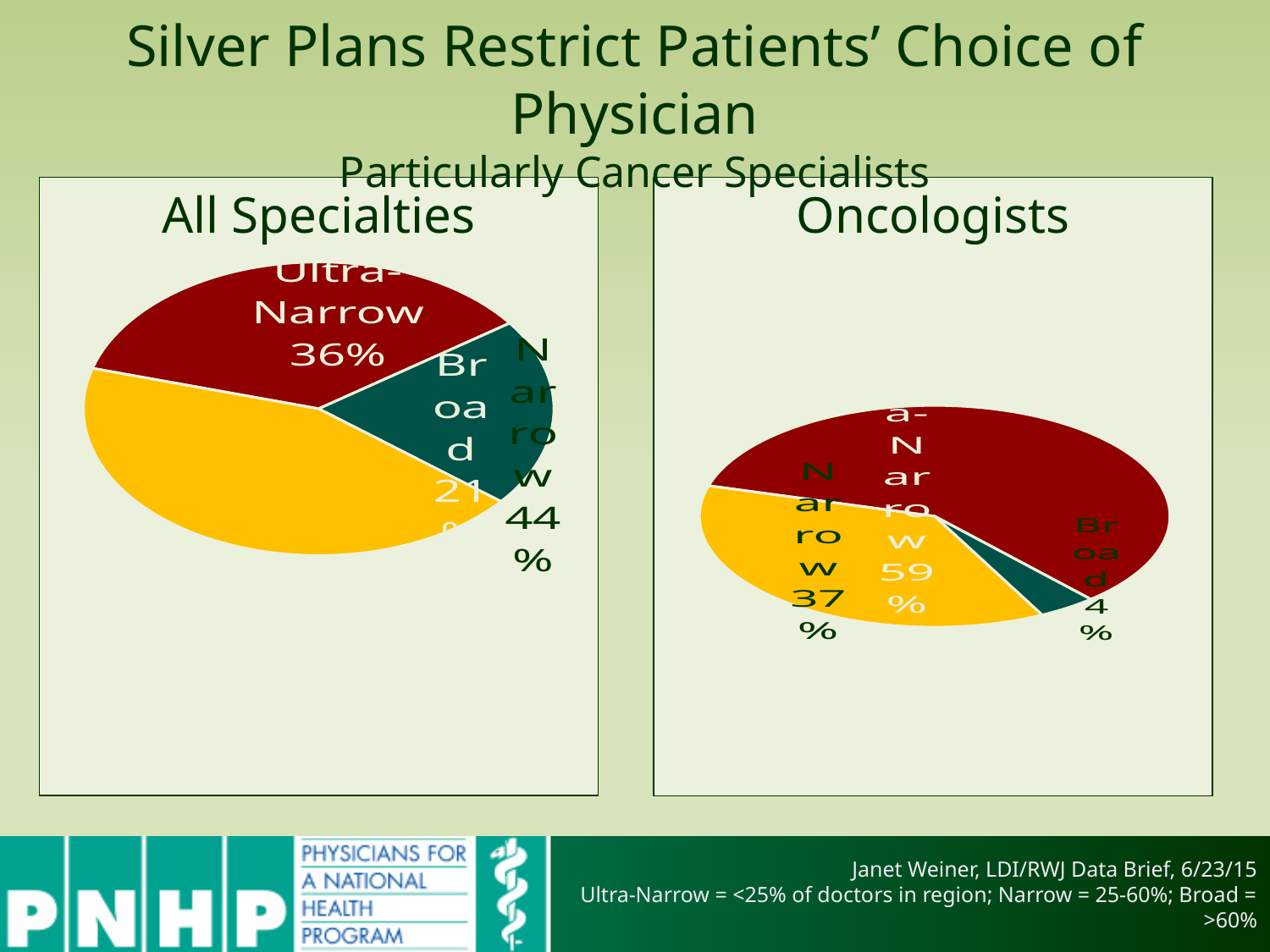
In the Oncologists chart, what percentage is labelled for Narrow? 37% In the All Specialties chart, what percentage is labelled for Ultra-Narrow? 36% What type of charts are shown on the slide? Pie charts In the All Specialties chart, which category has the largest slice? Narrow In the Oncologists chart, what is the difference between the Ultra-Narrow and Narrow percentages? 22% In the All Specialties chart, what percentage is labelled for Narrow? 44% In the Oncologists chart, what percentage is labelled for Broad? 4% How many slices does the Oncologists pie chart have? 3 In the All Specialties chart, which category has the smallest slice? Broad In the Oncologists chart, which category has the smallest slice? Broad In the Oncologists chart, what percentage is labelled for the Ultra-Narrow slice? 59% In the Oncologists chart, which category has the largest slice? Ultra-Narrow